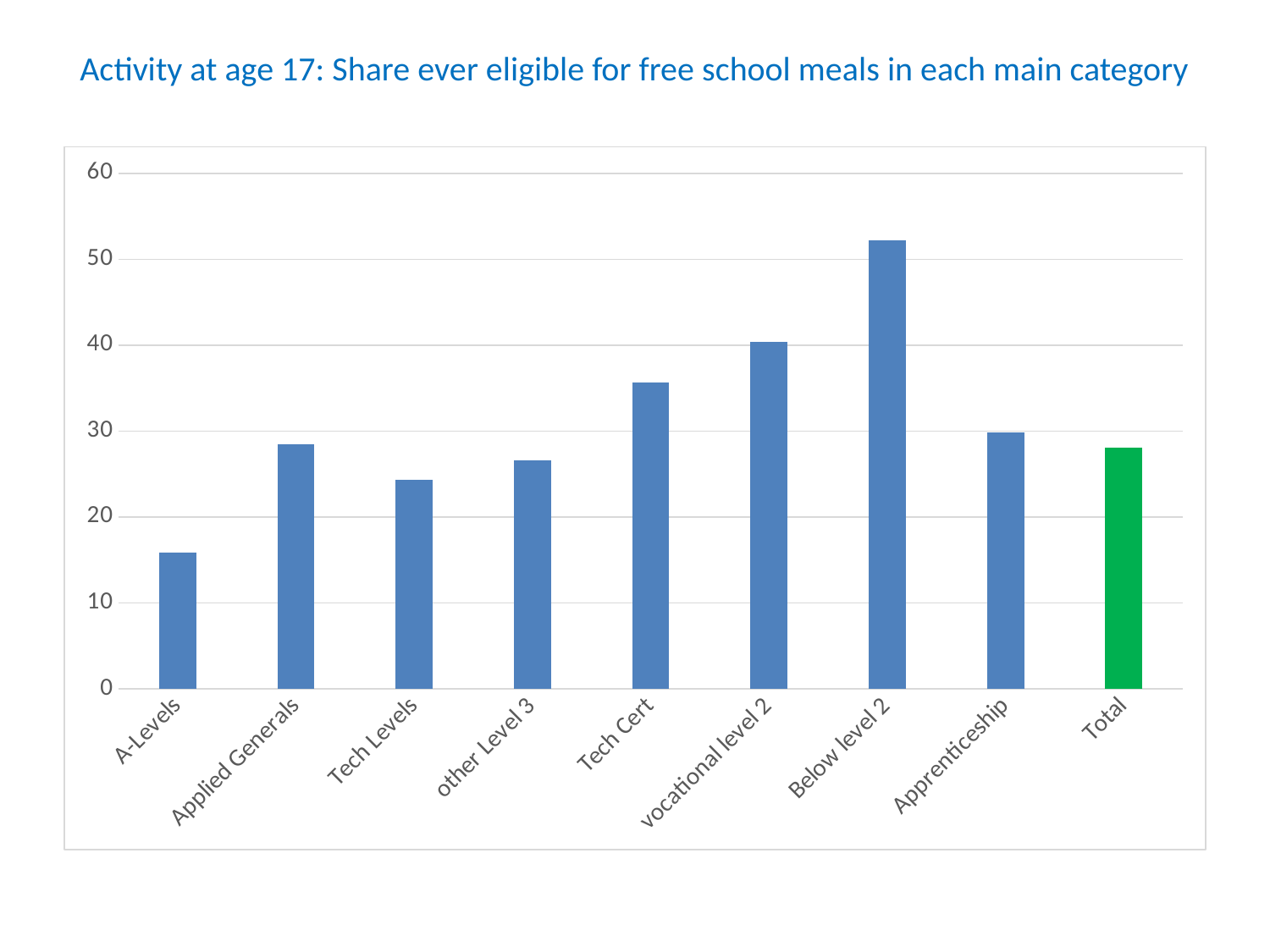
Is the value for Tech Cert greater or less than 30? greater Which bar is coloured green rather than blue? Total Is the value for Below level 2 greater or less than 50? greater Is the value for Tech Levels greater or less than 20? greater Which is larger, the value for Tech Cert or the value for Tech Levels? Tech Cert Which is larger, the value for vocational level 2 or the value for Below level 2? Below level 2 How many categories are shown on the x axis? 9 What kind of chart is shown on the slide? bar chart Which category has the highest value? Below level 2 Which category has the lowest value? A-Levels What is the title of the chart? Activity at age 17: Share ever eligible for free school meals in each main category